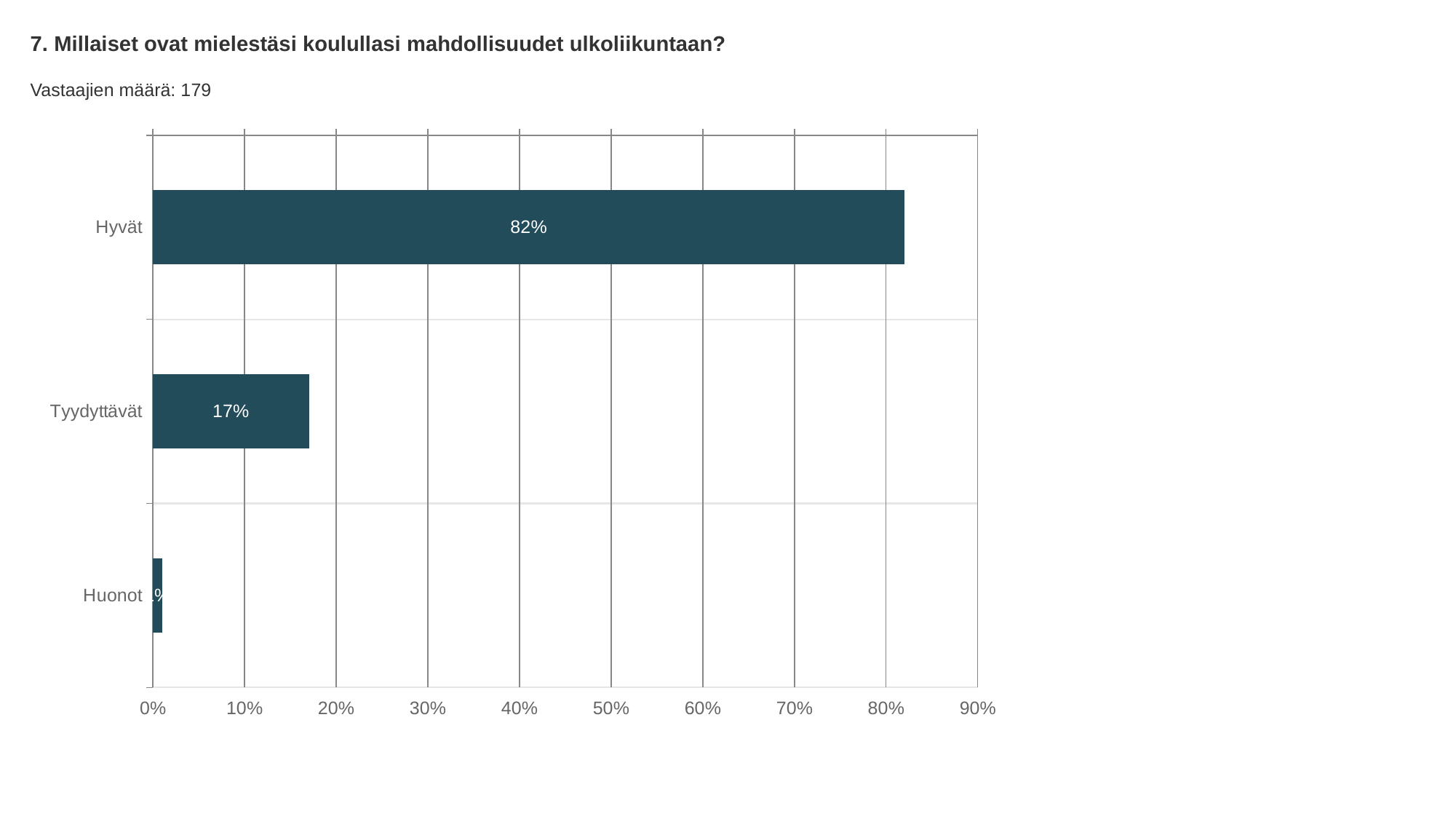
What kind of chart is shown on the slide? bar chart Is the value for Huonot greater or less than 10%? less Which is larger, the value for Tyydyttävät or the value for Huonot? Tyydyttävät Which category has the highest value? Hyvät What is the difference between the values for Hyvät and Tyydyttävät? 65% What is the highest value shown on the x axis? 90% Which category has the lowest value? Huonot What is the value for Hyvät? 82% What is the value for Tyydyttävät? 17% Is the value for Hyvät greater or less than 80%? greater How many categories are shown in the chart? 3 How many respondents (Vastaajien määrä) are stated on the slide? 179